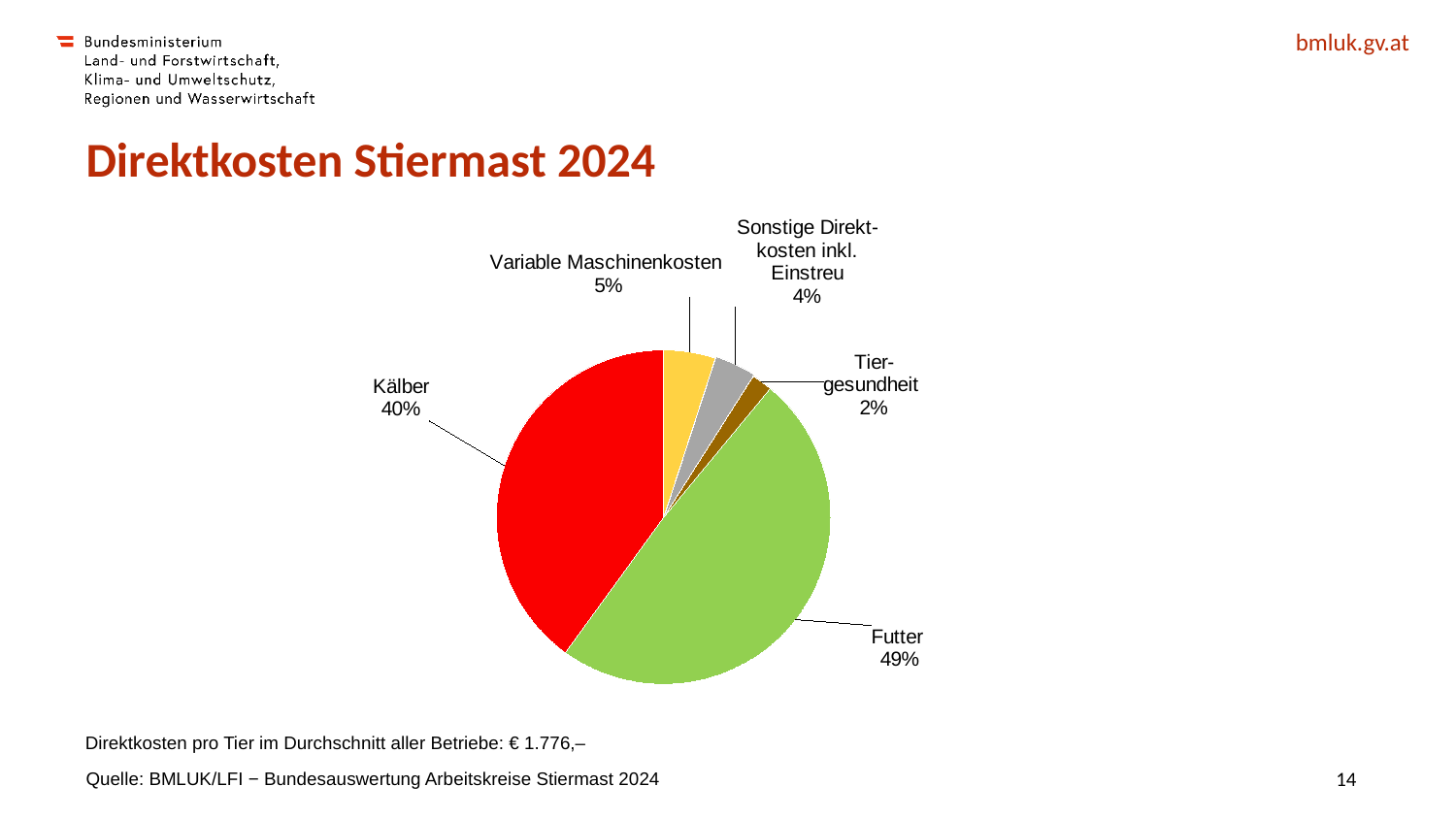
What is the title of the slide containing the chart? Direktkosten Stiermast 2024 Which category has the largest share of the pie? Futter Which is larger, the share for Variable Maschinenkosten or the share for Sonstige Direktkosten inkl. Einstreu? Variable Maschinenkosten Which category has the smallest share of the pie? Tiergesundheit What share of the pie does Kälber account for? 40% What is the difference in percentage points between Futter and Kälber? 9 What share of the pie does Futter account for? 49% What is the value shown for Variable Maschinenkosten? 5% How many categories are shown in the pie chart? 5 What kind of chart is shown on the slide? Pie chart What is the value shown for Sonstige Direktkosten inkl. Einstreu? 4% What is the value shown for Tiergesundheit? 2%